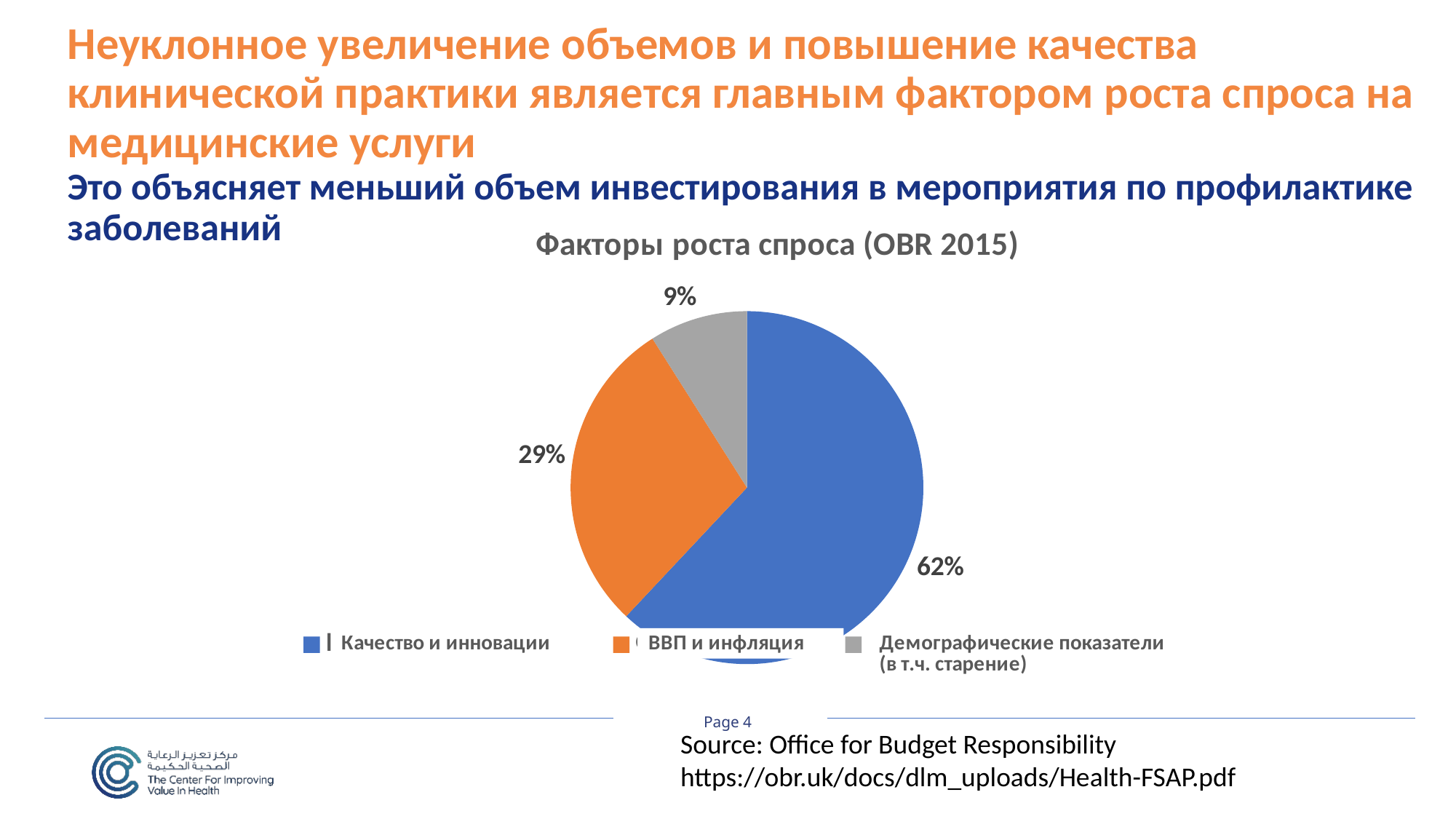
What is the difference in percentage points between Качество и инновации and ВВП и инфляция? 33 What kind of chart is shown on the slide? pie chart What share of the pie is labelled for ВВП и инфляция? 29% What share of the pie is labelled for Демографические показатели (в т.ч. старение)? 9% How many slices does the pie chart have? 3 Which category has the largest slice of the pie? Качество и инновации Which is larger, the slice for ВВП и инфляция or the slice for Демографические показатели (в т.ч. старение)? ВВП и инфляция What colour is the slice for ВВП и инфляция? orange Which category has the smallest slice of the pie? Демографические показатели (в т.ч. старение) What is the chart's title? Факторы роста спроса (OBR 2015) How many entries does the legend list? 3 What share of the pie is labelled for Качество и инновации? 62%